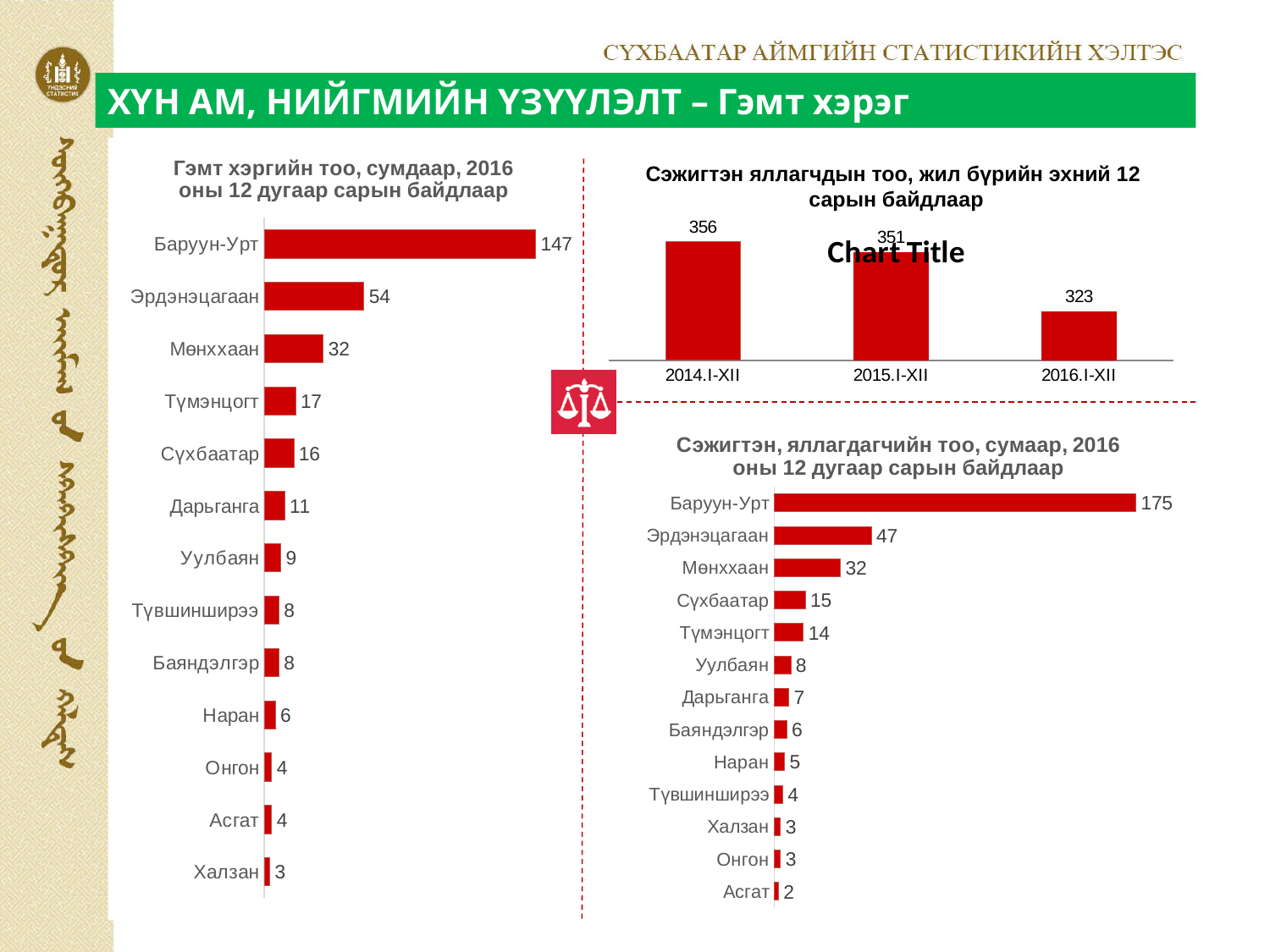
In the left chart 'Гэмт хэргийн тоо, сумдаар, 2016 оны 12 дугаар сарын байдлаар', what is the value for Баруун-Урт? 147 In the top-right chart 'Сэжигтэн яллагчдын тоо', what is the difference between 2014.I-XII and 2016.I-XII? 33 In the left chart 'Гэмт хэргийн тоо, сумдаар', what is the difference between Эрдэнэцагаан and Мөнххаан? 22 In the top-right chart 'Сэжигтэн яллагчдын тоо, жил бүрийн эхний 12 сарын байдлаар', what is the value for 2015.I-XII? 351 In the left chart 'Гэмт хэргийн тоо, сумдаар', which is larger, Түмэнцогт or Сүхбаатар? Түмэнцогт In the left chart 'Гэмт хэргийн тоо, сумдаар', which category has the lowest value? Халзан In the left chart 'Гэмт хэргийн тоо, сумдаар', how many categories are shown? 13 In the top-right chart 'Сэжигтэн яллагчдын тоо', which year has the highest value? 2014.I-XII What type of chart is the bottom-right chart 'Сэжигтэн, яллагдагчийн тоо, сумаар'? bar chart In the bottom-right chart 'Сэжигтэн, яллагдагчийн тоо, сумаар', which category has the lowest value? Асгат In the bottom-right chart 'Сэжигтэн, яллагдагчийн тоо, сумаар, 2016 оны 12 дугаар сарын байдлаар', what is the value for Баруун-Урт? 175 In the top-right chart 'Сэжигтэн яллагчдын тоо', do the values rise or fall from 2014.I-XII to 2016.I-XII? fall